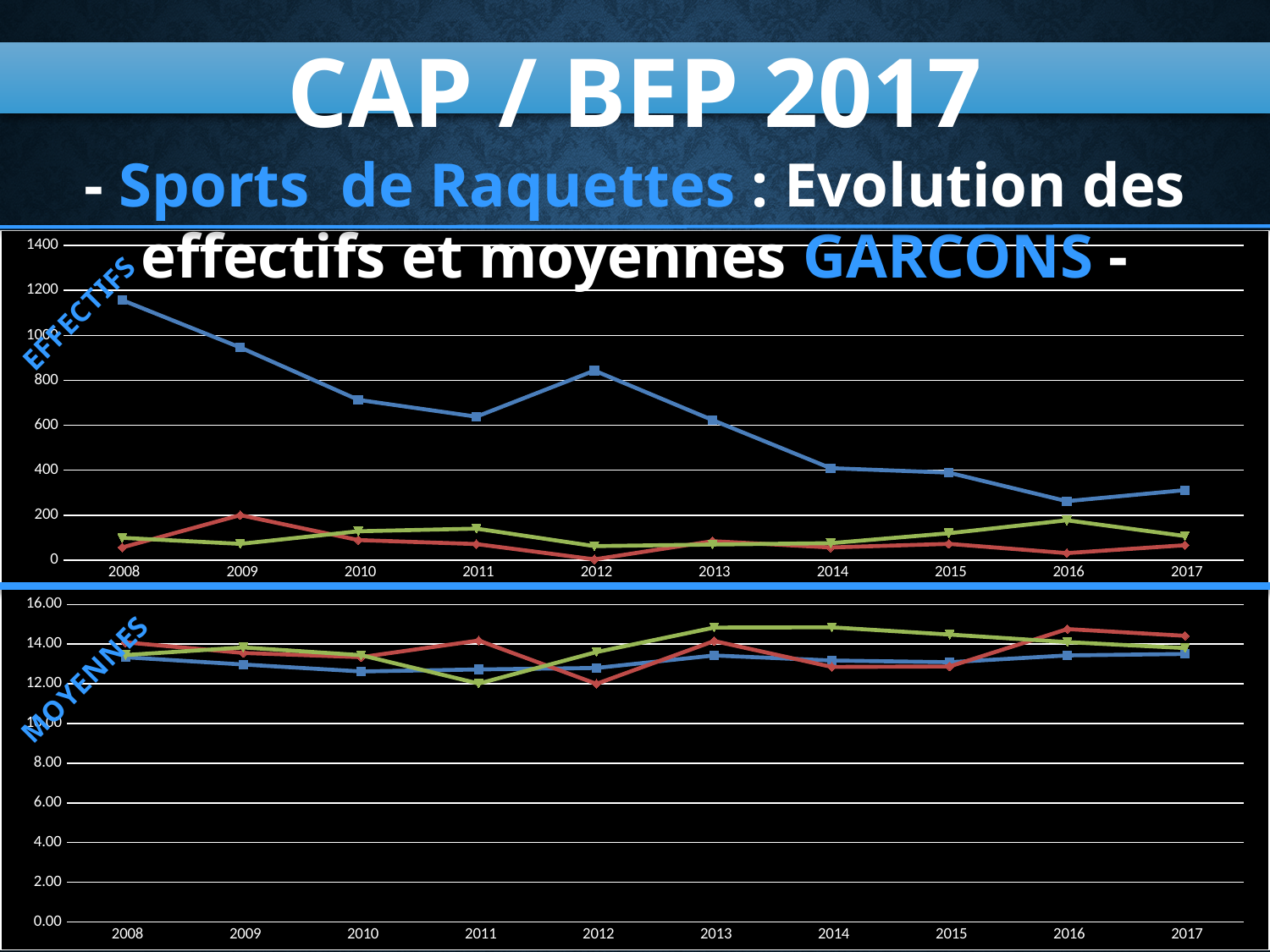
In the bottom chart (MOYENNES), is the value of the blue line in 2010 greater or less than 14.00? less In the top chart (EFFECTIFS), is the value of the blue line in 2008 greater or less than 1000? greater In the top chart (EFFECTIFS), in which year is the blue line at its highest? 2008 What is the first year shown on the x axis of the bottom chart (MOYENNES)? 2008 In the top chart (EFFECTIFS), is the value of the blue line in 2016 greater or less than 400? less In the top chart (EFFECTIFS), is the blue line higher in 2009 or in 2012? 2009 What label is written along the left side of the bottom chart? MOYENNES In the top chart (EFFECTIFS), does the blue line overall rise or fall from 2008 to 2017? Fall How many years are shown on the x axis of the top chart (EFFECTIFS)? 10 What type of chart is the top chart labelled EFFECTIFS? Line chart